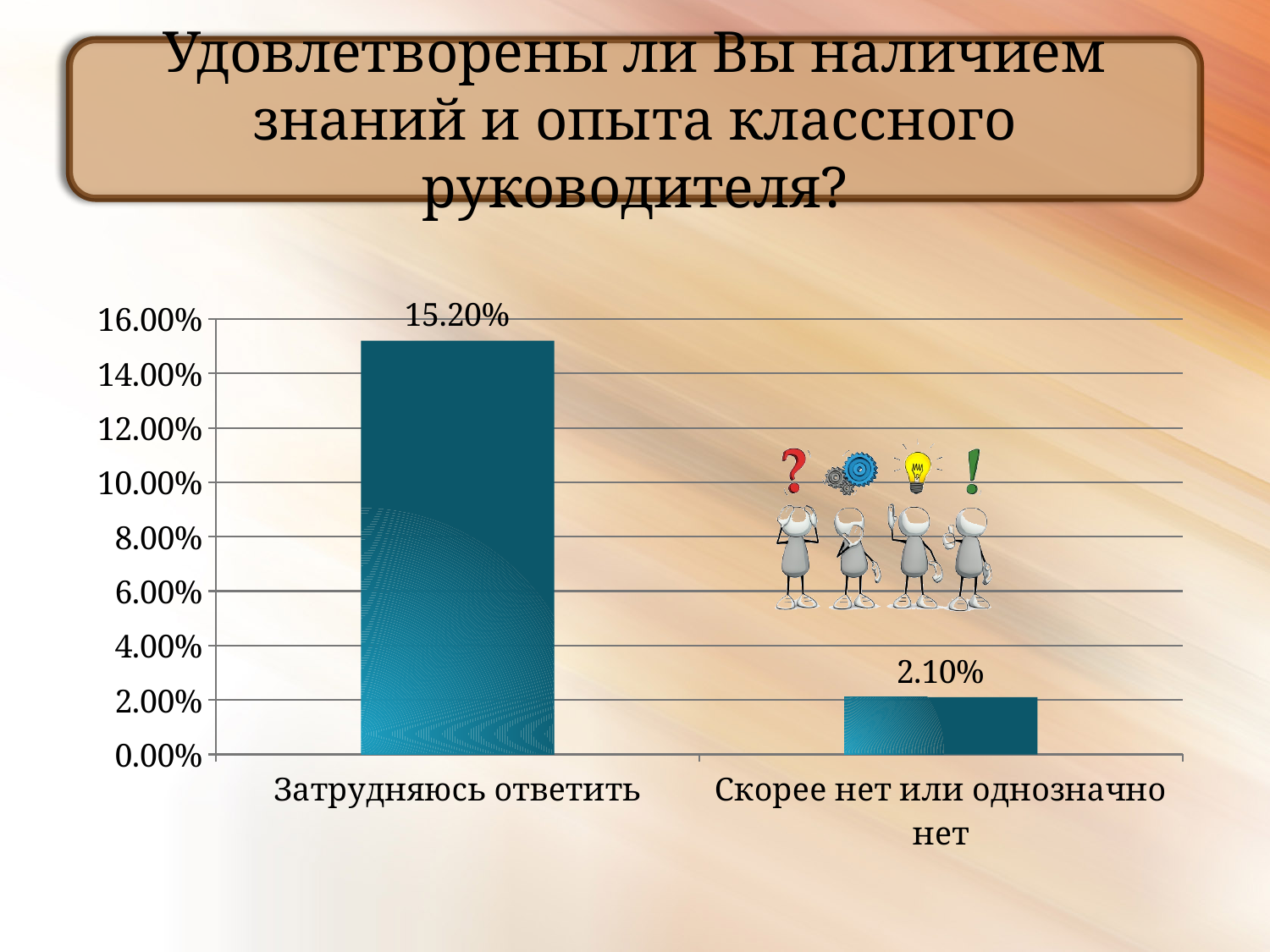
What kind of chart is shown on the slide? bar chart How many categories are shown on the chart? 2 What is the total of the two values shown on the chart? 17.30% What is the value for "Затрудняюсь ответить"? 15.20% What is the highest value shown on the vertical axis? 16.00% What is the difference between the values for "Затрудняюсь ответить" and "Скорее нет или однозначно нет"? 13.10% Is the value for "Затрудняюсь ответить" greater or less than 14.00%? greater Which category has the lowest value? Скорее нет или однозначно нет What is the value for "Скорее нет или однозначно нет"? 2.10% Which category has the highest value? Затрудняюсь ответить Which is larger: the value for "Затрудняюсь ответить" or for "Скорее нет или однозначно нет"? Затрудняюсь ответить Is the value for "Скорее нет или однозначно нет" greater or less than 4.00%? less